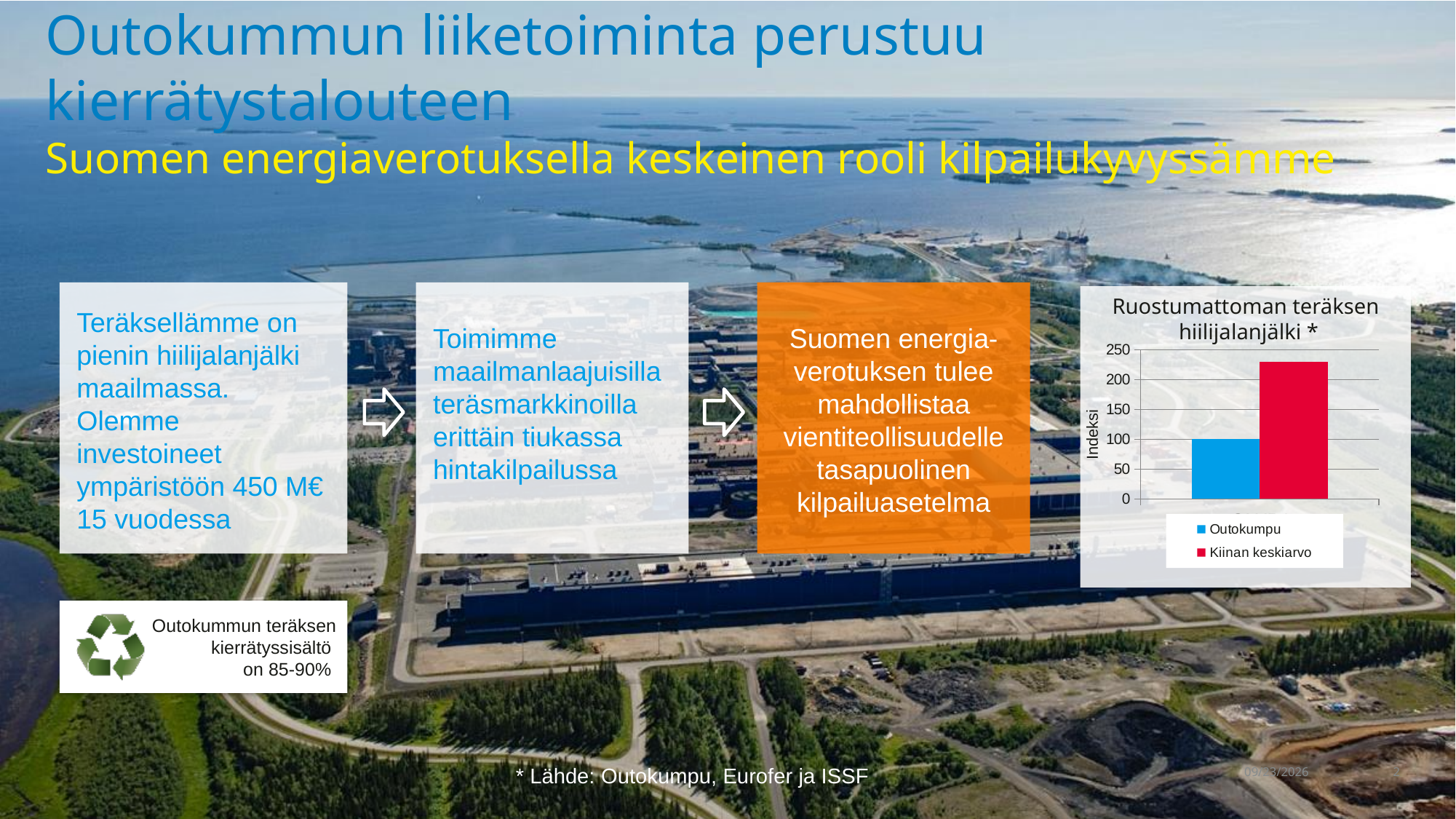
How many bars are plotted in the chart? 2 What is the value for Outokumpu in the chart? 100 Which series has the highest value in the chart? Kiinan keskiarvo Is the value for Kiinan keskiarvo greater or less than 200? greater Is the value for Kiinan keskiarvo greater or less than 250? less Which series has the lowest value in the chart? Outokumpu What kind of chart is shown on the slide? bar chart What is the title of the chart? Ruostumattoman teräksen hiilijalanjälki * Which is larger, the value for Outokumpu or the value for Kiinan keskiarvo? Kiinan keskiarvo What is the label of the chart's vertical axis? Indeksi How many series does the chart legend list? 2